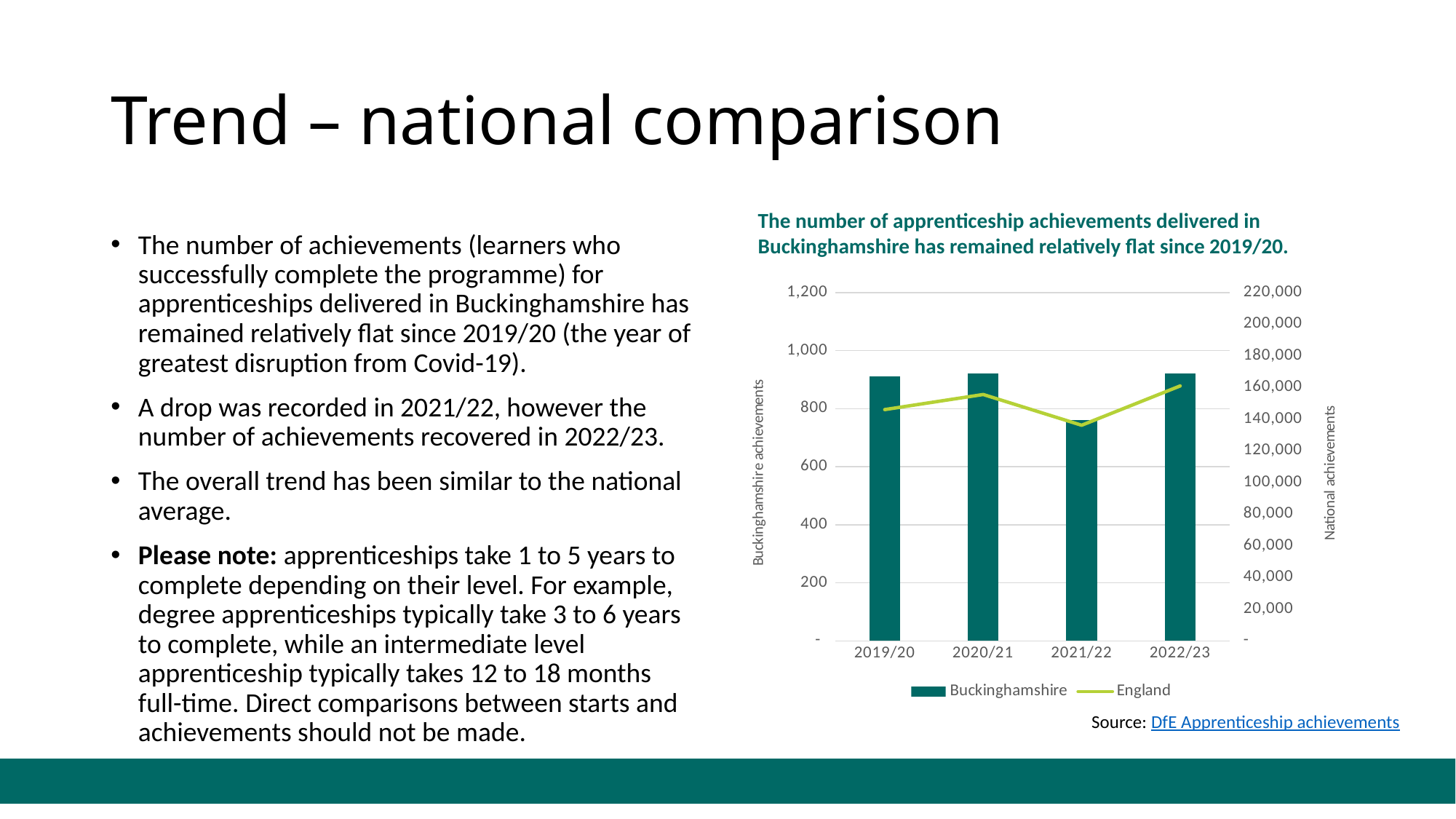
Which series is plotted as a line in the chart? England What kind of chart is shown on the slide? A bar chart combined with a line Is the Buckinghamshire value for 2019/20 greater or less than 800? greater Which is larger for Buckinghamshire: the value for 2019/20 or the value for 2021/22? 2019/20 Is the Buckinghamshire value for 2020/21 greater or less than 1,000? less Is the England value for 2022/23 greater or less than 140,000? greater How many years are shown on the x axis of the chart? 4 How many series does the chart legend list? 2 In which year is the England line at its lowest point? 2021/22 Which year has the lowest Buckinghamshire achievements bar? 2021/22